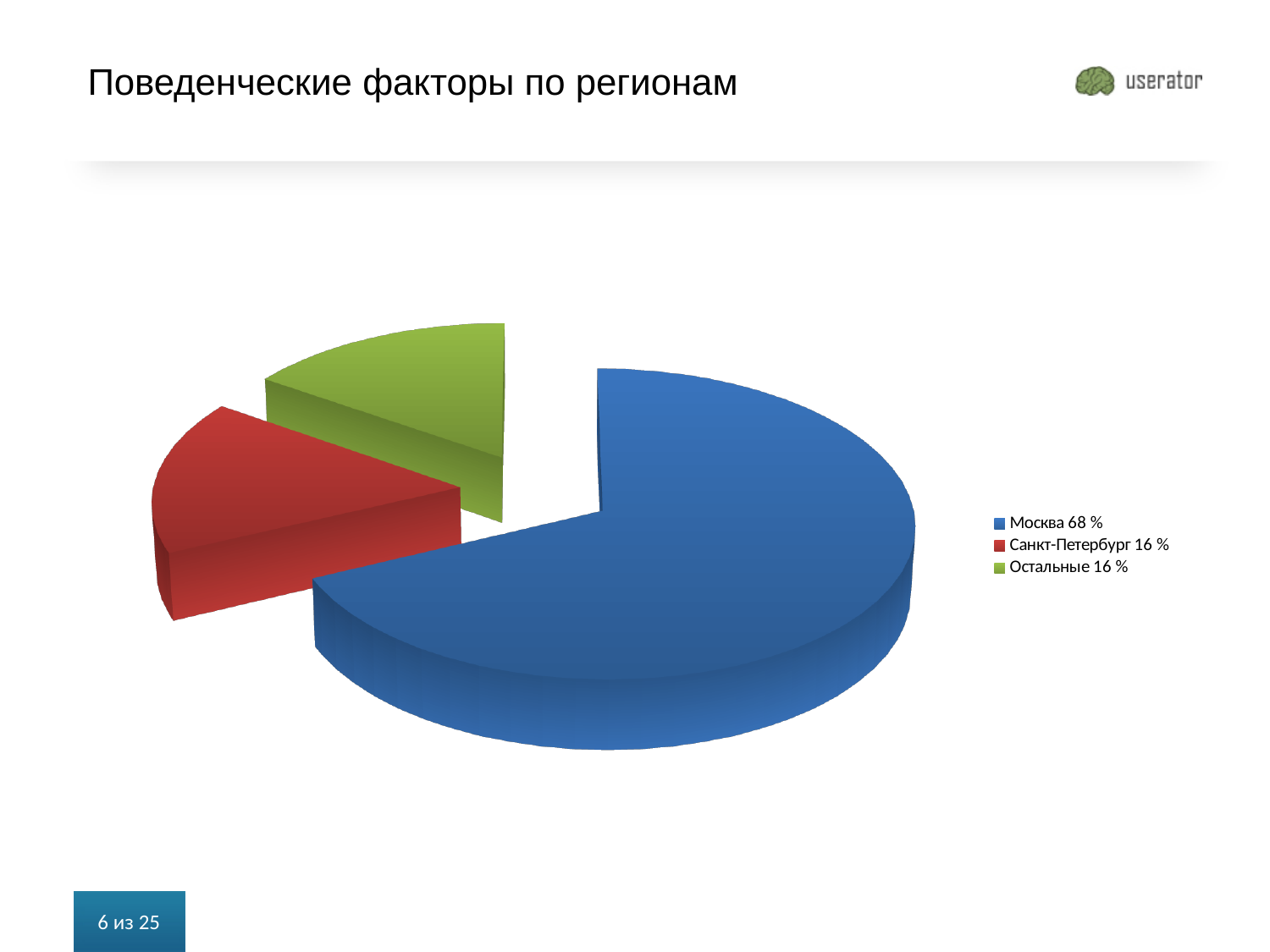
How many slices does the pie chart have? 3 Which is larger, the share for Москва or the share for Санкт-Петербург? Москва What is the title of the chart slide? Поведенческие факторы по регионам Which region has the largest slice of the pie? Москва What colour is the slice for Санкт-Петербург? red What share of the pie does Москва have? 68 % What kind of chart is shown on the slide? pie chart What share of the pie does Остальные have? 16 % Is the share for Москва greater or less than 50 %? greater What share of the pie does Санкт-Петербург have? 16 % Do Санкт-Петербург and Остальные have the same share of the pie? Yes, 16 % each What is the difference between the share for Москва and the share for Остальные? 52 %